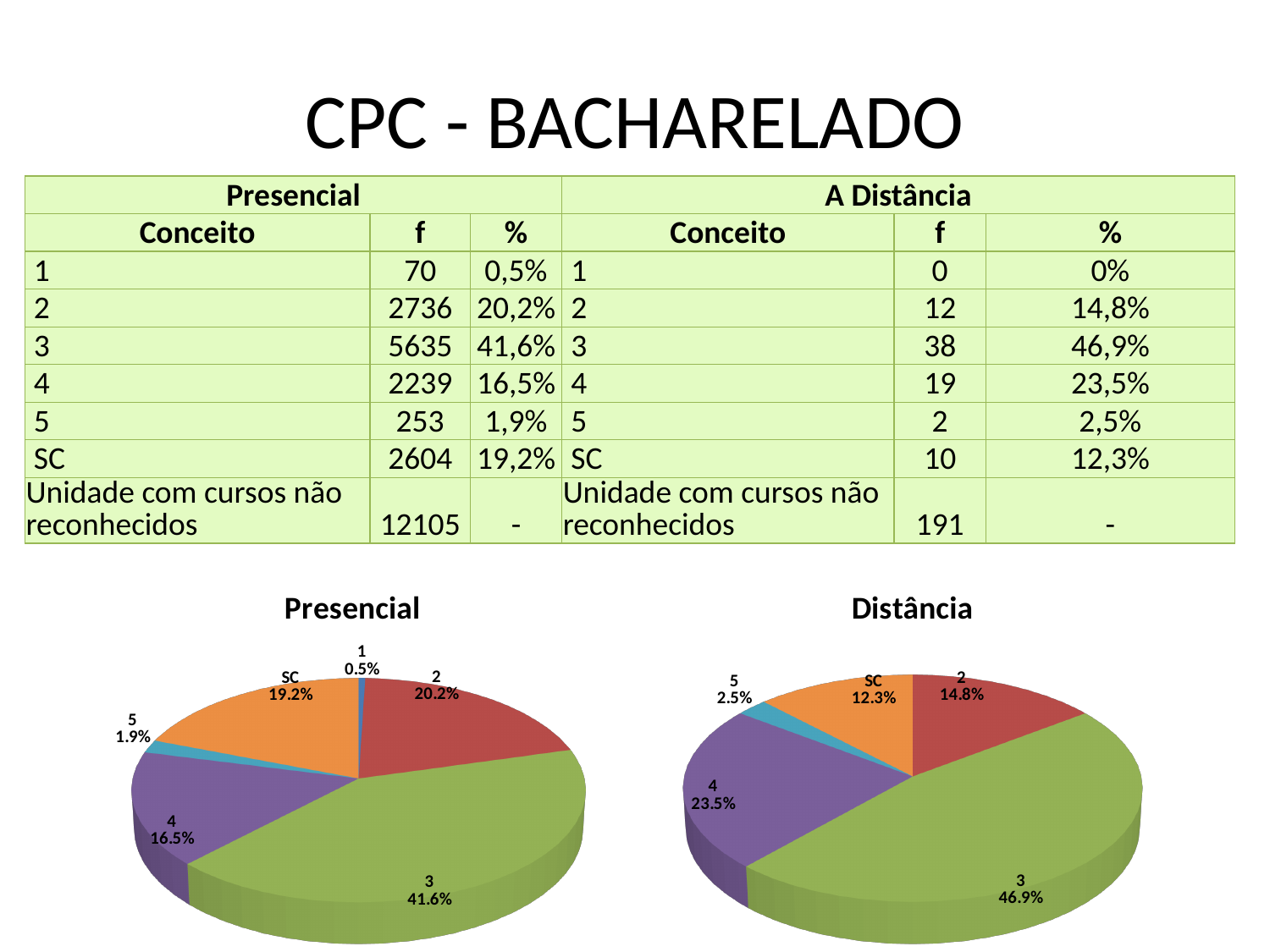
In the Presencial pie chart, which is larger: the slice for SC or the slice for category 4? SC In the Presencial pie chart, which category has the smallest slice? 1 In the Distância pie chart, which category has the largest slice? 3 In the Distância pie chart, which category has the smallest slice? 5 How many labeled slices does the Presencial pie chart have? 6 In the Distância pie chart, what is the difference between the shares of category 3 and category 2? 32.1% In the Presencial pie chart, what share is shown for category 3? 41.6% How many labeled slices does the Distância pie chart have? 5 In the Distância pie chart, what share is shown for category 4? 23.5% In the Presencial pie chart, what is the difference between the shares of category 2 and category 4? 3.7% What type of chart is used for Presencial and Distância? Pie chart In the Presencial pie chart, what share is shown for SC? 19.2%